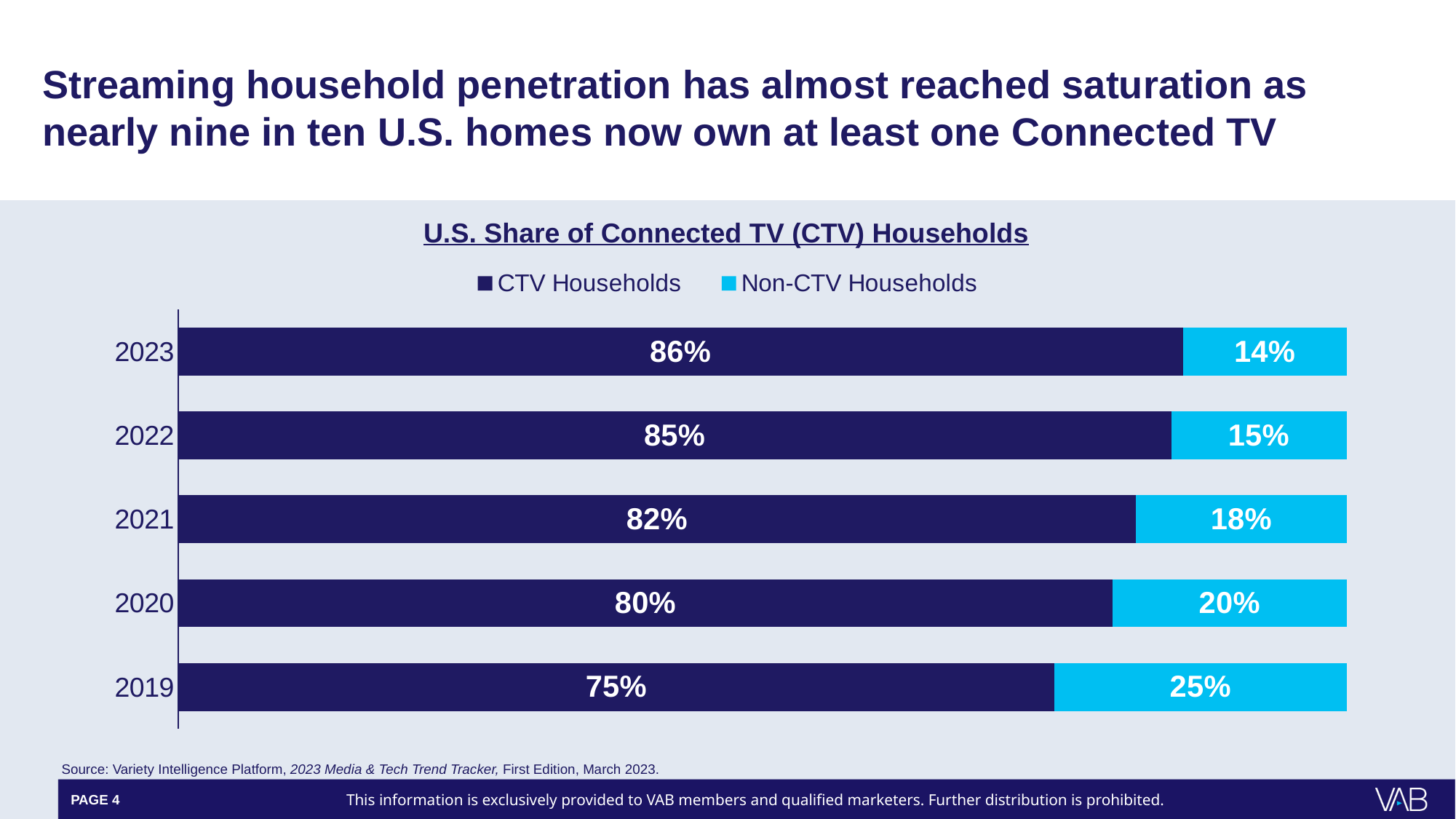
What is the difference between the CTV Households share in 2023 and in 2019? 11 percentage points What kind of chart is shown on the slide? Stacked bar chart How many years are shown on the chart? 5 Which year has the highest CTV Households share? 2023 Does the CTV Households share rise or fall from 2019 to 2023? Rise Which year has the lowest CTV Households share? 2019 What is the CTV Households share for 2023? 86% Which is larger: the Non-CTV Households share in 2020 or in 2022? 2020 What is the Non-CTV Households share for 2019? 25% What is the CTV Households share for 2021? 82% How many series does the legend list? 2 What is the title of the chart? U.S. Share of Connected TV (CTV) Households